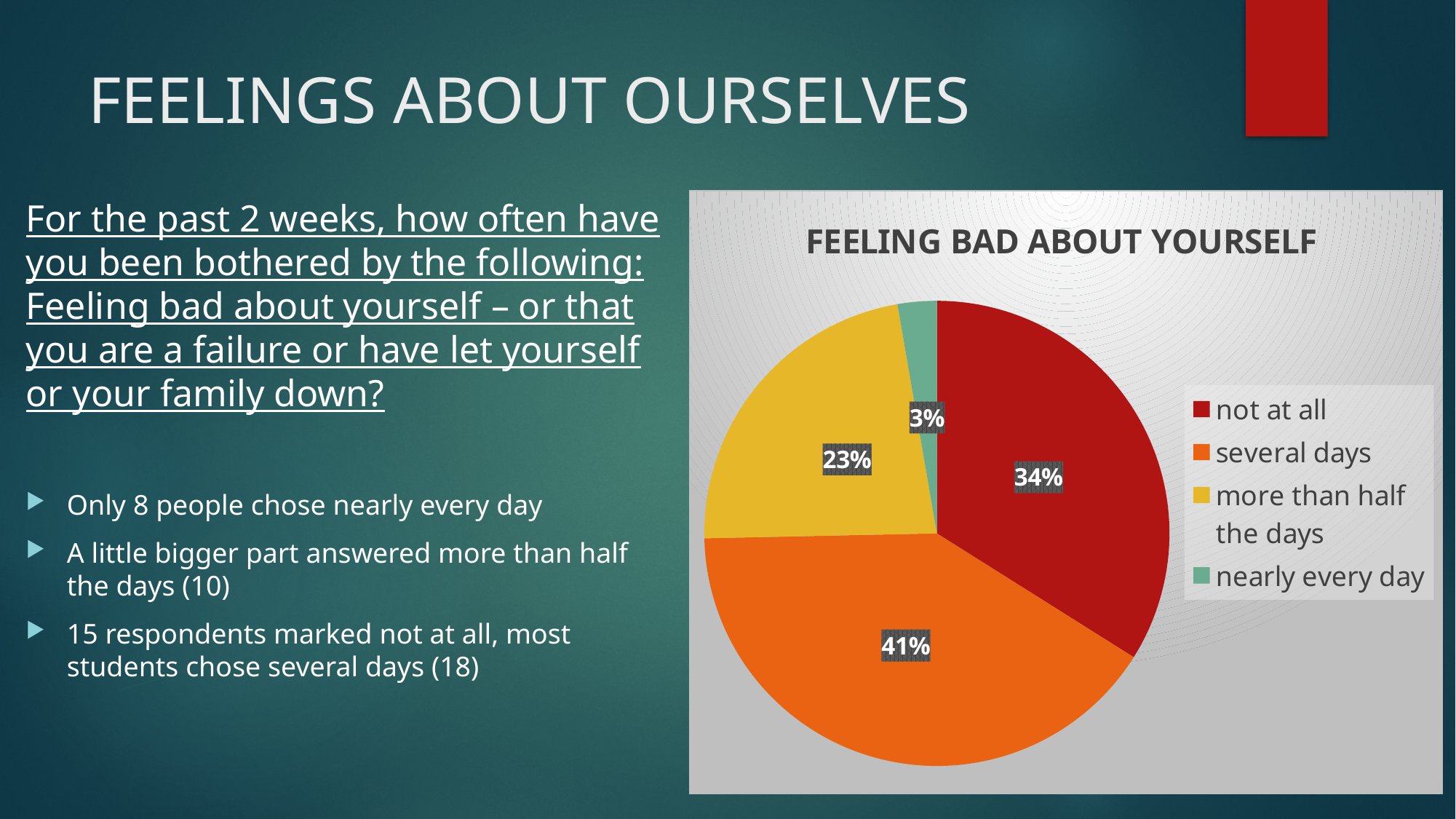
What kind of chart is shown on the slide? pie chart How many categories does the pie chart show? 4 What is the title of the chart? FEELING BAD ABOUT YOURSELF Which slice is larger: 'more than half the days' or 'nearly every day'? more than half the days What share of the pie is labelled 'not at all'? 34% Which category has the largest slice of the pie? several days What share of the pie is labelled 'more than half the days'? 23% What share of the pie is labelled 'nearly every day'? 3% What colour is the 'not at all' slice in the pie chart? red What share of the pie is labelled 'several days'? 41% Which category has the smallest slice of the pie? nearly every day What is the difference in percentage points between the 'several days' slice and the 'not at all' slice? 7